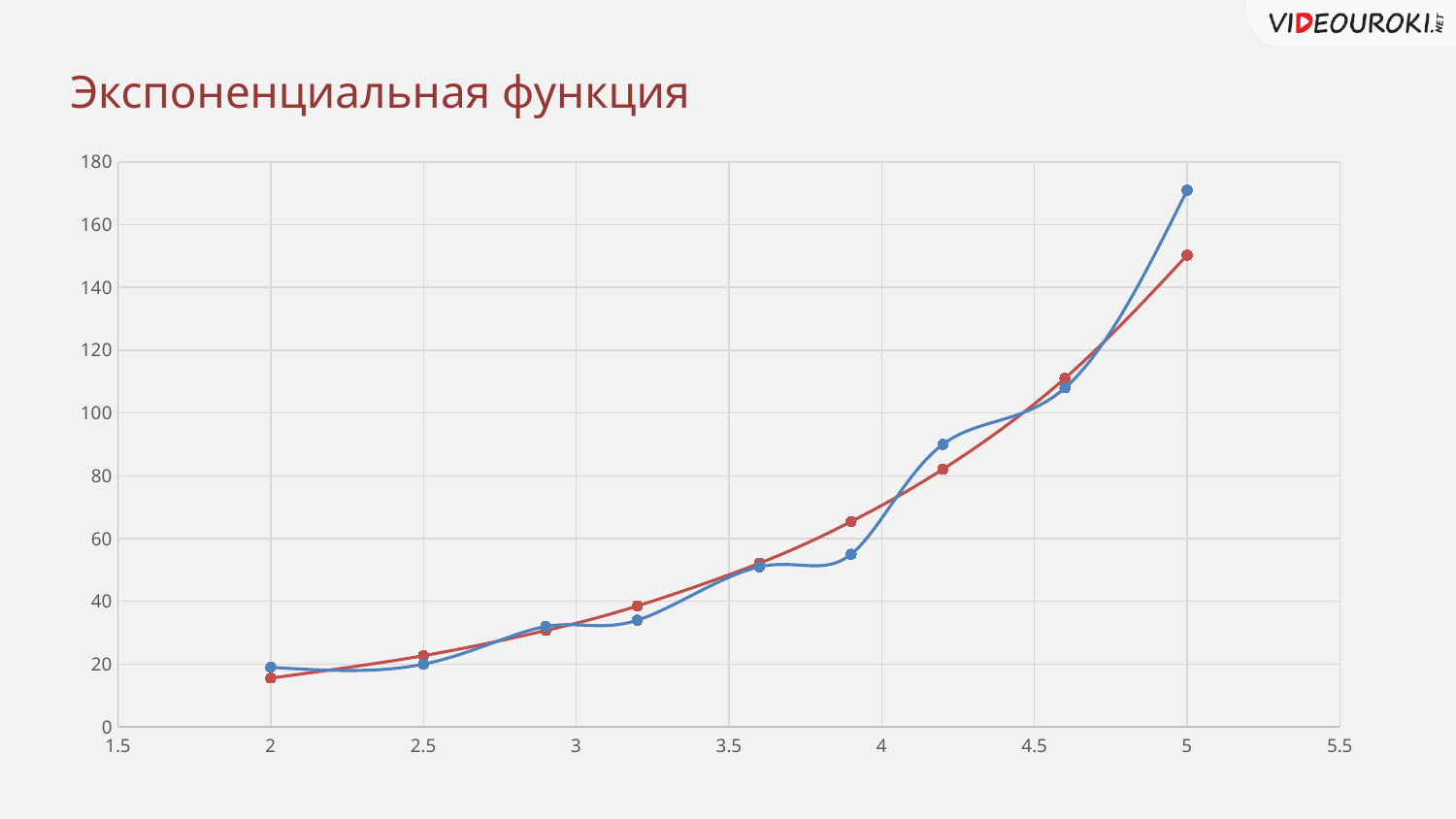
What kind of chart is shown on the slide? line chart At x = 3.9, which line has the higher value, the blue or the red? red At x = 5, which line has the higher value, the blue or the red? blue How many lines (series) are plotted on the chart? 2 How many data points does the blue line have? 9 Do the values of the blue line rise or fall as x increases from 2 to 5? rise Is the value of the blue line at x = 3.9 greater or less than 60? less Is the value of the blue line at x = 5 greater or less than 160? greater Is the value of the blue line at x = 4.6 greater or less than 100? greater What is the title of the chart? Экспоненциальная функция At which x value does the blue line reach its highest point? 5